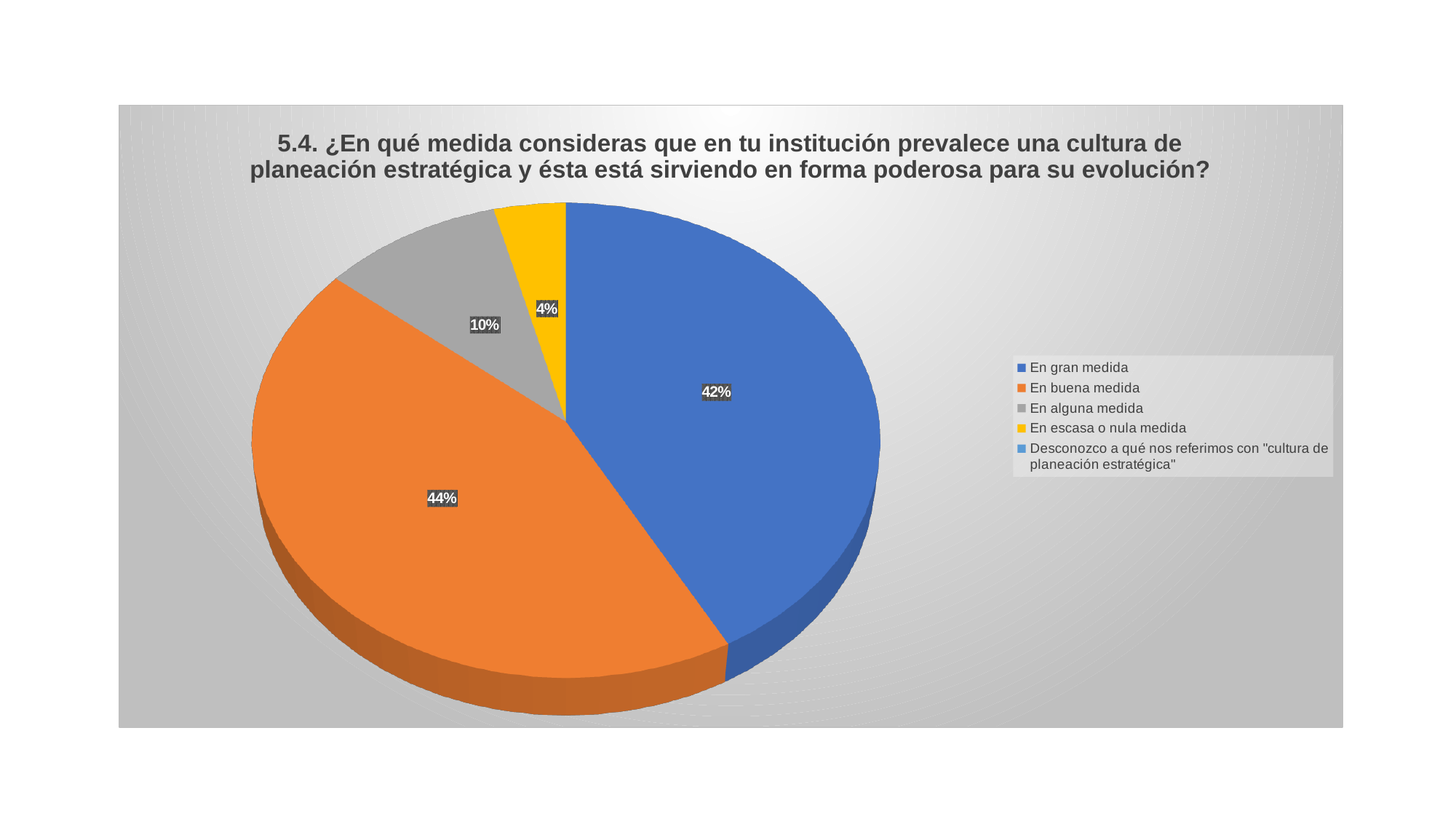
Which category with a visible slice has the smallest share of the pie? En escasa o nula medida What colour is the slice for "En escasa o nula medida"? Yellow How many entries does the legend list? 5 What share of the pie does "En buena medida" represent? 44% What percentage is shown for "En escasa o nula medida"? 4% Which category has the largest slice of the pie? En buena medida What type of chart is shown on the slide? Pie chart What percentage is shown for "En alguna medida"? 10% What is the difference in percentage points between "En buena medida" and "En gran medida"? 2 What is the combined share of "En gran medida" and "En buena medida"? 86% What share of the pie does "En gran medida" represent? 42% Which is larger, the share for "En alguna medida" or the share for "En escasa o nula medida"? En alguna medida